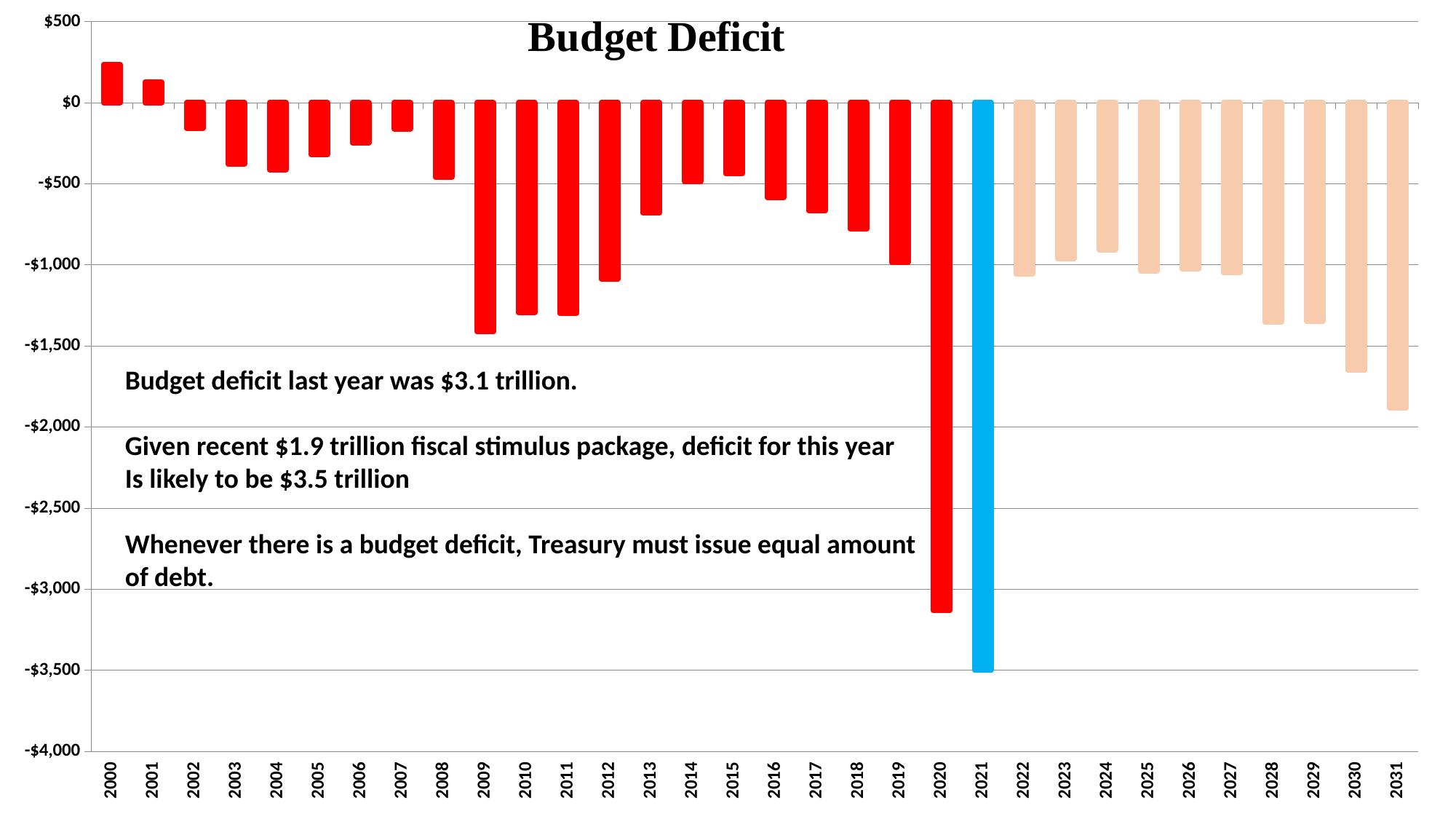
Which year's bar is coloured blue in the chart? 2021 Which year has the highest value in the chart? 2000 Which year has the larger value, 2009 or 2012? 2012 Is the value for 2020 greater or less than -$3,000? less What kind of chart is shown on the slide? bar chart Do the values generally rise or fall from 2022 to 2031? fall Which year has the lowest value in the chart? 2021 Is the value for 2013 greater or less than -$1,000? greater Is the value for 2031 greater or less than -$1,500? less What is the title of the chart? Budget Deficit How many years are plotted on the x axis of the chart? 32